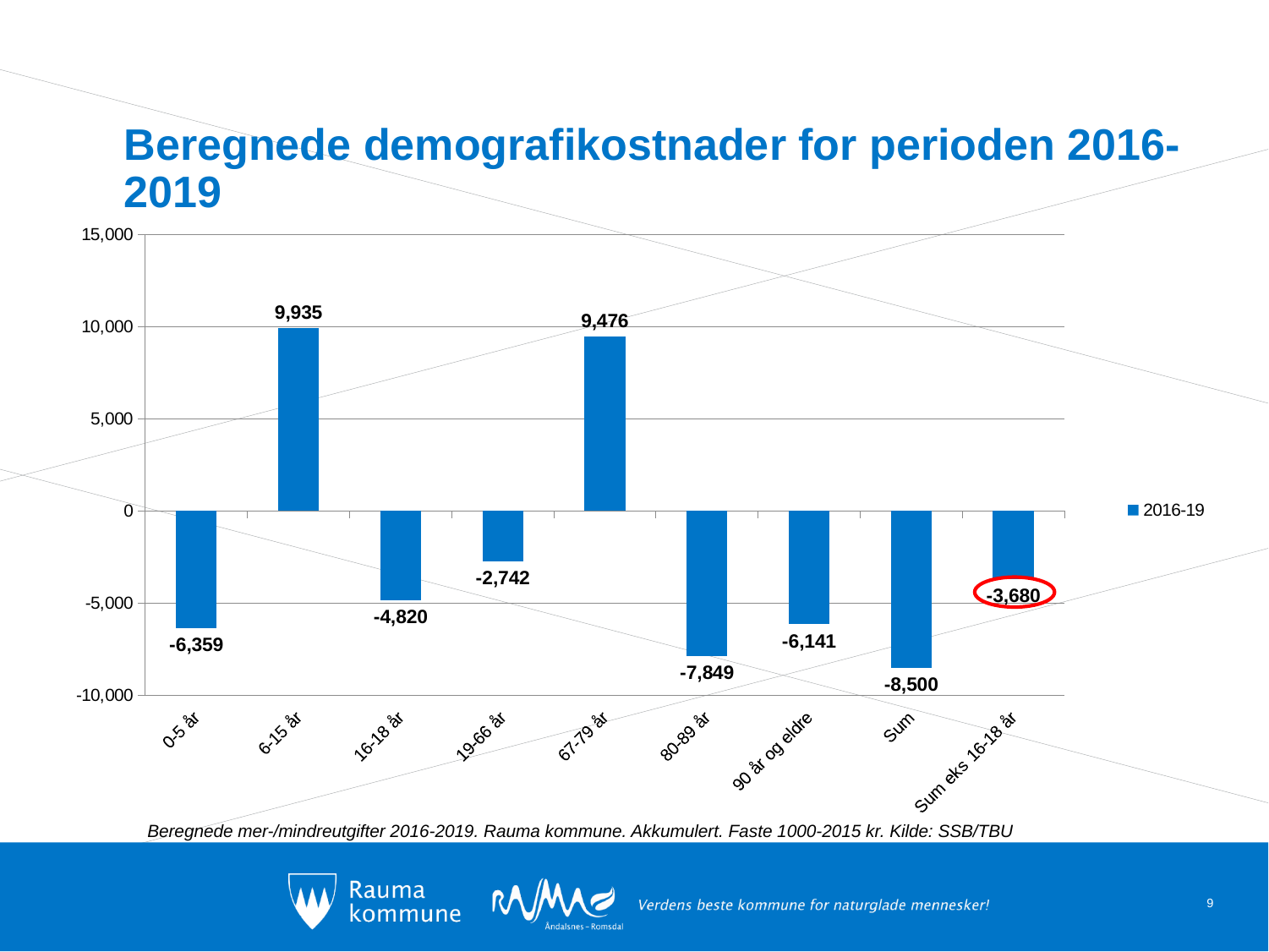
Which category has the highest value? 6-15 år What is the value for 6-15 år? 9,935 How many categories are shown on the x axis? 9 Which category has the lowest value? Sum What is the value for 80-89 år? -7,849 Is the value for 19-66 år greater or less than -5,000? greater What kind of chart is shown on the slide? Bar chart What is the difference between the values for 6-15 år and 67-79 år? 459 Which is larger, the value for 0-5 år or the value for 16-18 år? 16-18 år What is the value for 90 år og eldre? -6,141 How many series does the legend list? 1 What is the value for Sum eks 16-18 år? -3,680